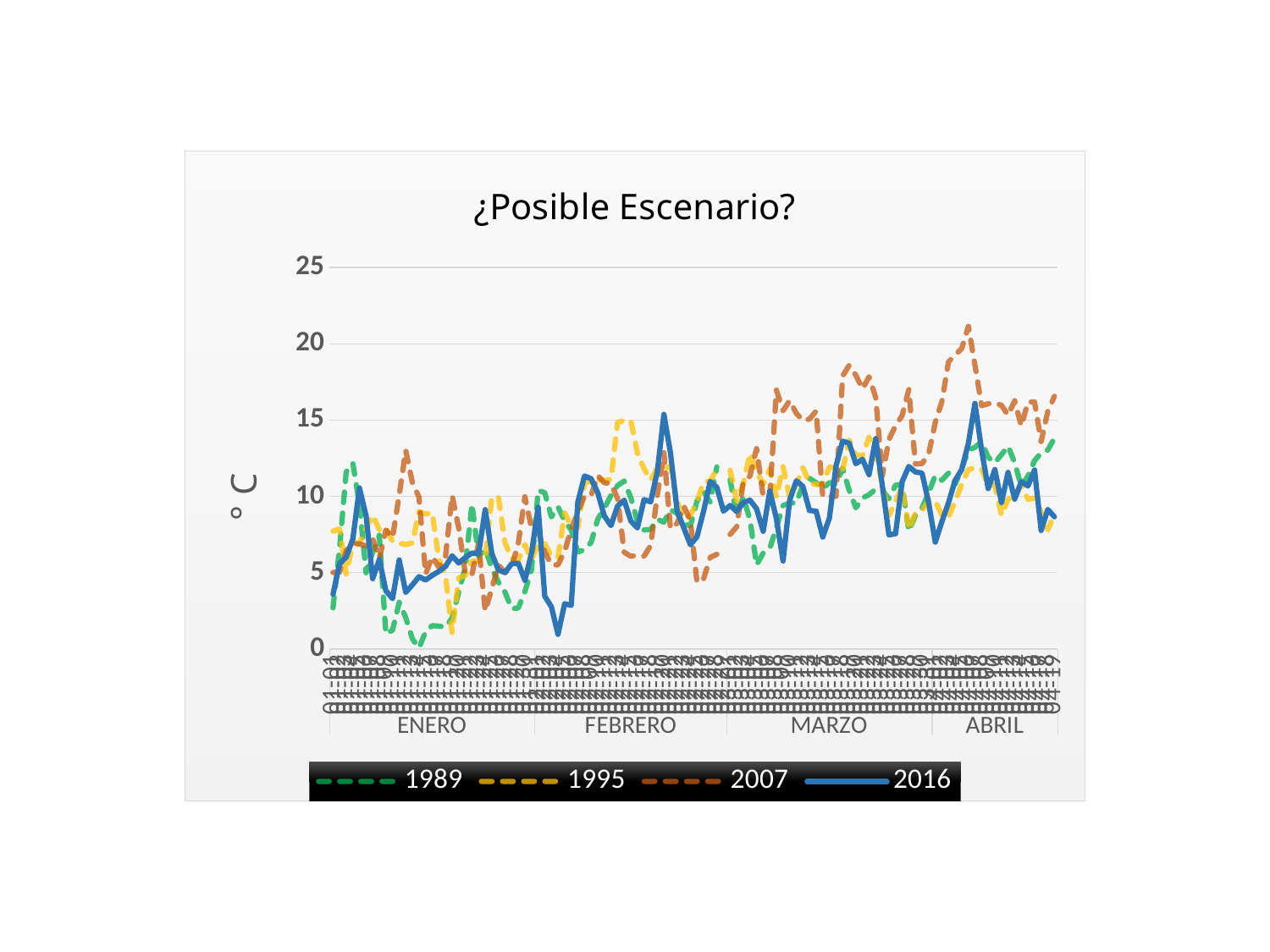
Which series reaches the highest value on the chart? 2007 How many months are labelled along the x axis? 4 How many series does the legend list? 4 What is the title of the chart? ¿Posible Escenario? What is the maximum value shown on the y axis? 25 Which years are listed in the legend? 1989, 1995, 2007, 2016 Is the highest value reached by the 2007 series greater or less than 20? greater What kind of chart is shown on the slide? Line chart Do the temperature values generally rise or fall from ENERO to ABRIL? rise Does any series exceed 25 on the chart? No Is the highest value reached by the 2016 series greater or less than 20? less